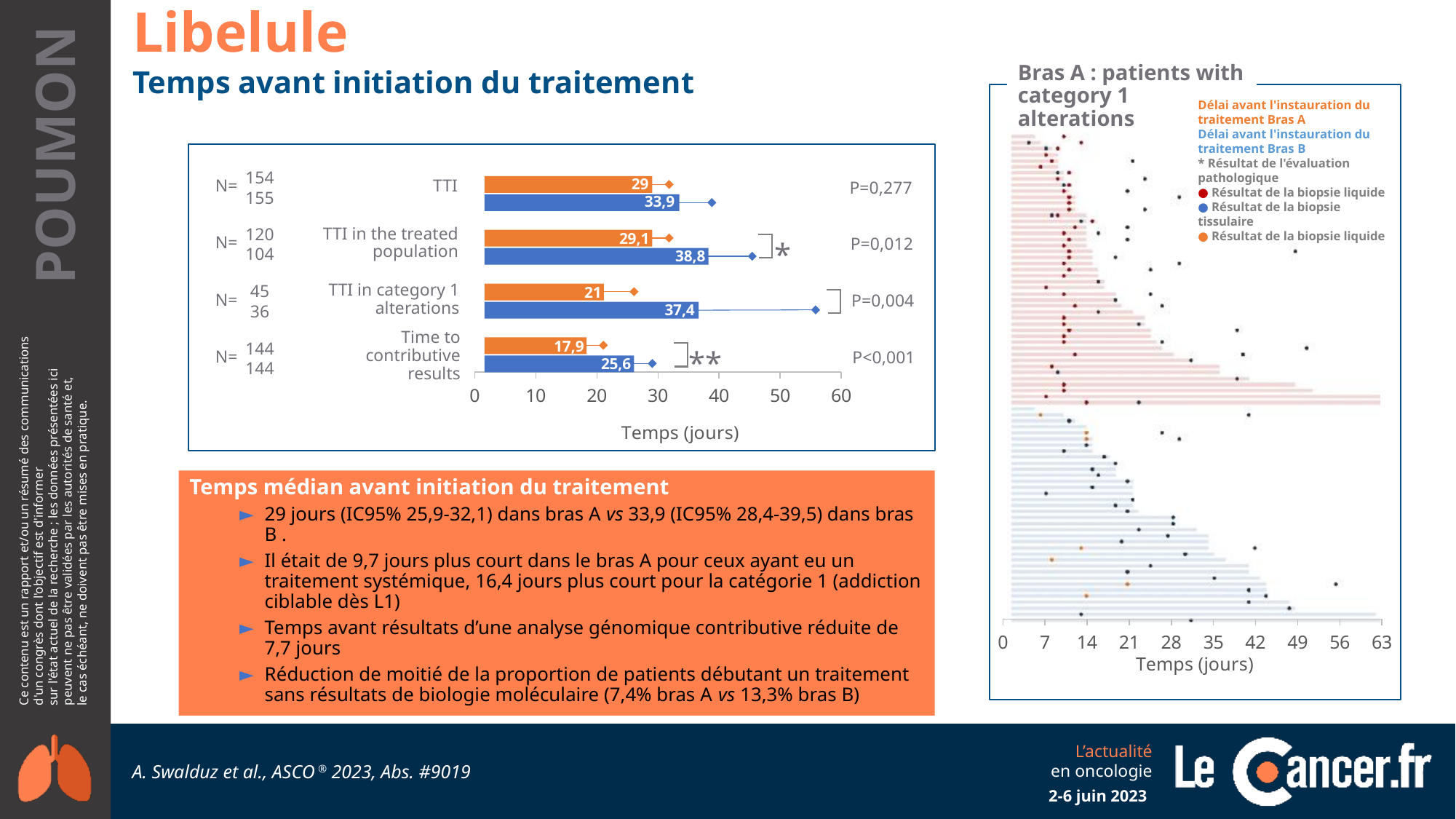
In the bar chart on the left, which is larger for TTI: the orange bar or the blue bar? the blue bar What kind of chart is the chart on the left of the slide? bar chart In the bar chart on the left, what is the value of the blue bar for Time to contributive results? 25,6 In the bar chart on the left, what is the difference between the blue and orange bars for TTI in category 1 alterations? 16,4 How many categories are shown in the bar chart on the left? 4 In the bar chart on the left, is the blue bar for TTI in category 1 alterations greater or less than 30? greater In the bar chart on the left, what is the value of the blue bar for TTI in the treated population? 38,8 In the bar chart on the left, what is the value of the orange bar for TTI? 29 What is the x-axis label of the bar chart on the left? Temps (jours) In the bar chart on the left, which category has the highest blue bar value? TTI in the treated population In the bar chart on the left, what is the value of the orange bar for TTI in category 1 alterations? 21 In the bar chart on the left, which category has the lowest orange bar value? Time to contributive results